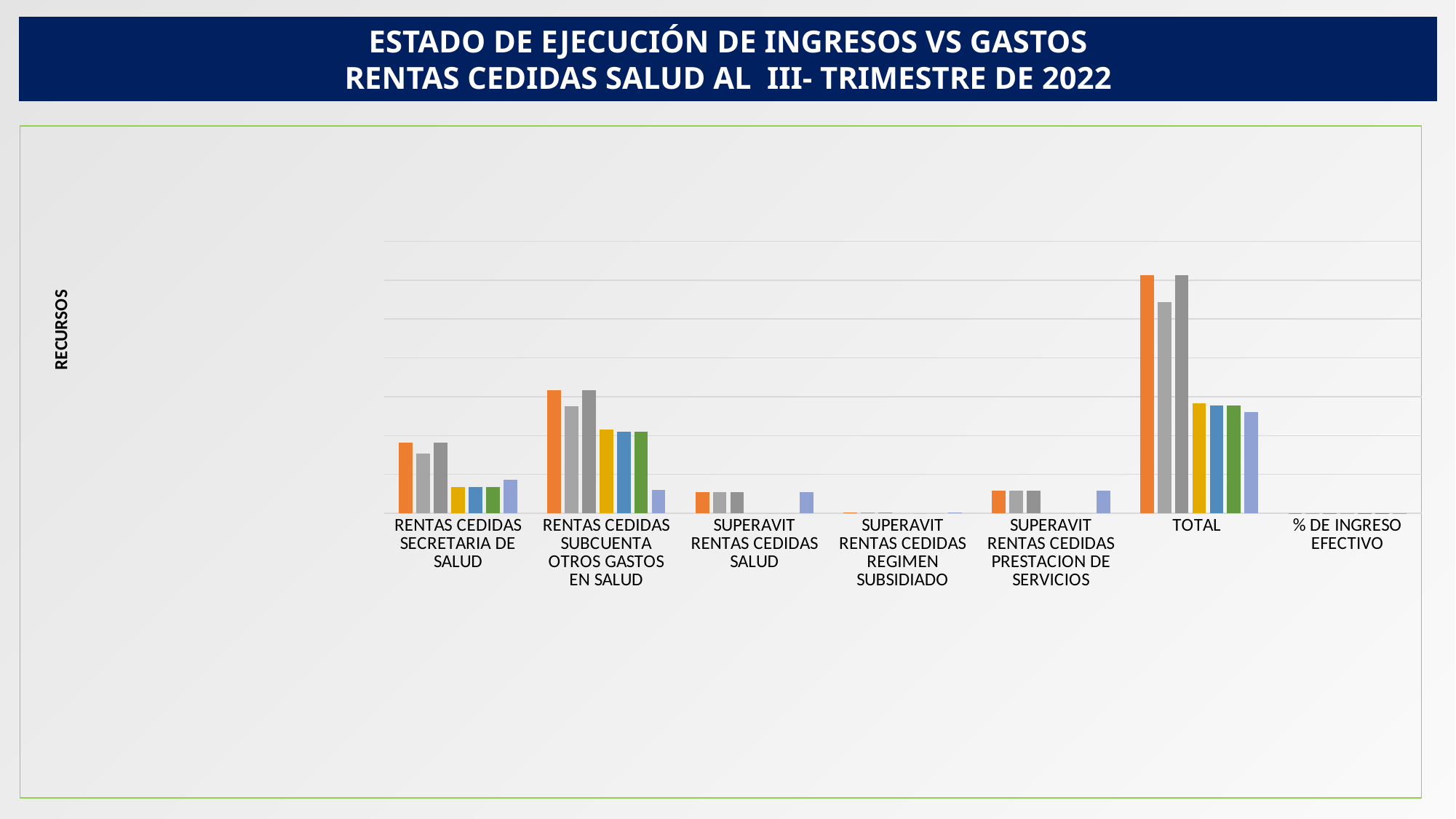
Which category has taller bars: RENTAS CEDIDAS SECRETARIA DE SALUD or RENTAS CEDIDAS SUBCUENTA OTROS GASTOS EN SALUD? RENTAS CEDIDAS SUBCUENTA OTROS GASTOS EN SALUD Which category has taller bars: TOTAL or RENTAS CEDIDAS SUBCUENTA OTROS GASTOS EN SALUD? TOTAL Which category has taller bars: SUPERAVIT RENTAS CEDIDAS SALUD or SUPERAVIT RENTAS CEDIDAS REGIMEN SUBSIDIADO? SUPERAVIT RENTAS CEDIDAS SALUD How many categories are shown along the x axis of the chart? 7 What kind of chart is shown on the slide? Bar chart What is the title shown above the chart? ESTADO DE EJECUCIÓN DE INGRESOS VS GASTOS RENTAS CEDIDAS SALUD AL III- TRIMESTRE DE 2022 Which category has the shortest bars in the chart? % DE INGRESO EFECTIVO How many bars are plotted for the TOTAL category? 7 What is the label on the vertical axis of the chart? RECURSOS Which category has the tallest bars in the chart? TOTAL